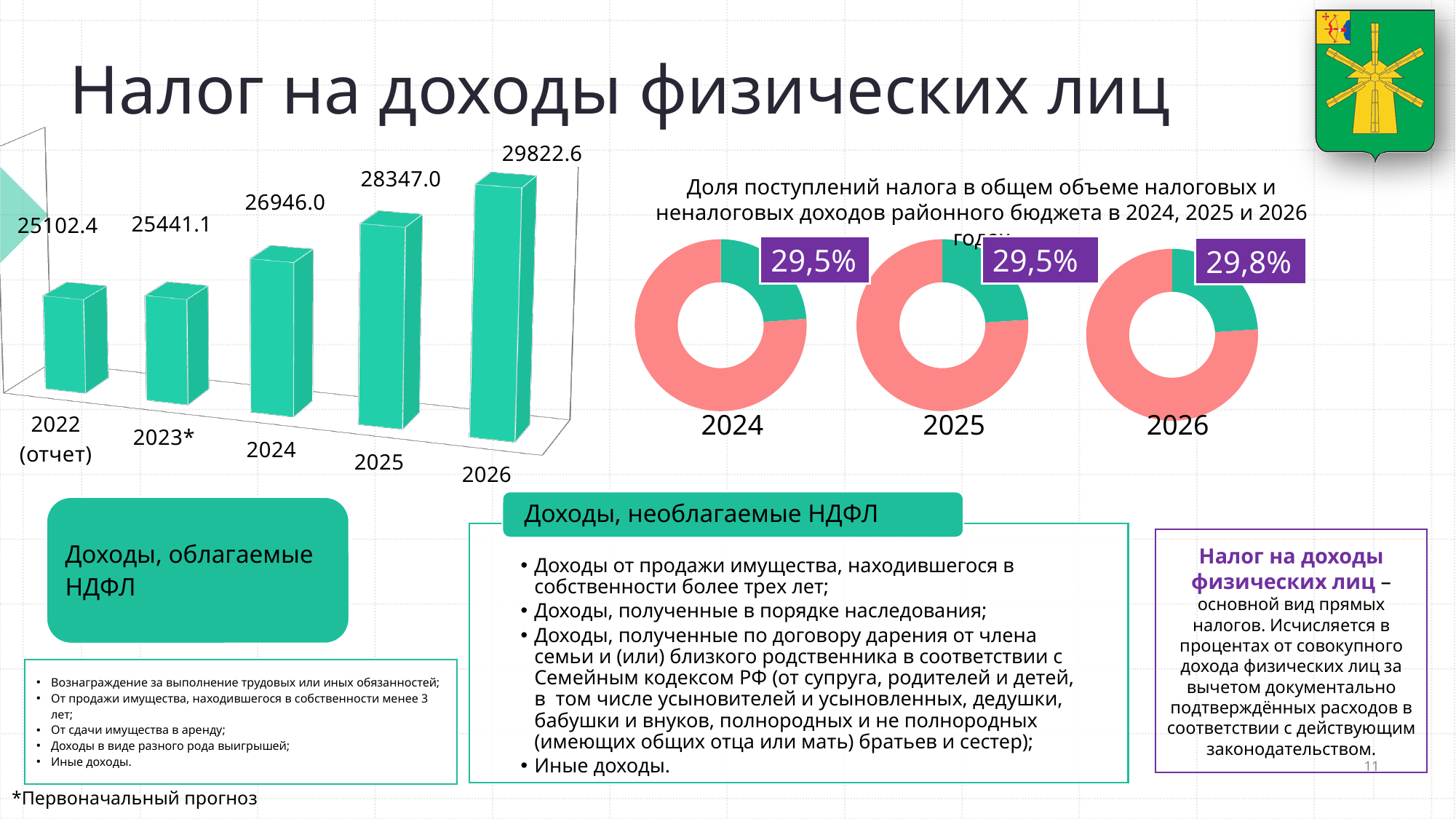
On the bar chart on the left, which year has the lowest value? 2022 (отчет) On the bar chart on the left, what is the difference between the values for 2026 and 2025? 1475.6 On the donut charts on the right, what share is shown for 2024? 29,5% On the bar chart on the left, what is the value for 2022 (отчет)? 25102.4 On the bar chart on the left, what is the difference between the values for 2023* and 2022 (отчет)? 338.7 On the bar chart on the left, what is the value for 2024? 26946.0 Do the values on the bar chart on the left rise or fall from 2022 to 2026? rise On the bar chart on the left, which is larger: the value for 2025 or the value for 2024? 2025 On the bar chart on the left, what is the value for 2026? 29822.6 On the bar chart on the left, which year has the highest value? 2026 How many bars are on the bar chart on the left? 5 On the donut charts on the right, what share is shown for 2026? 29,8%